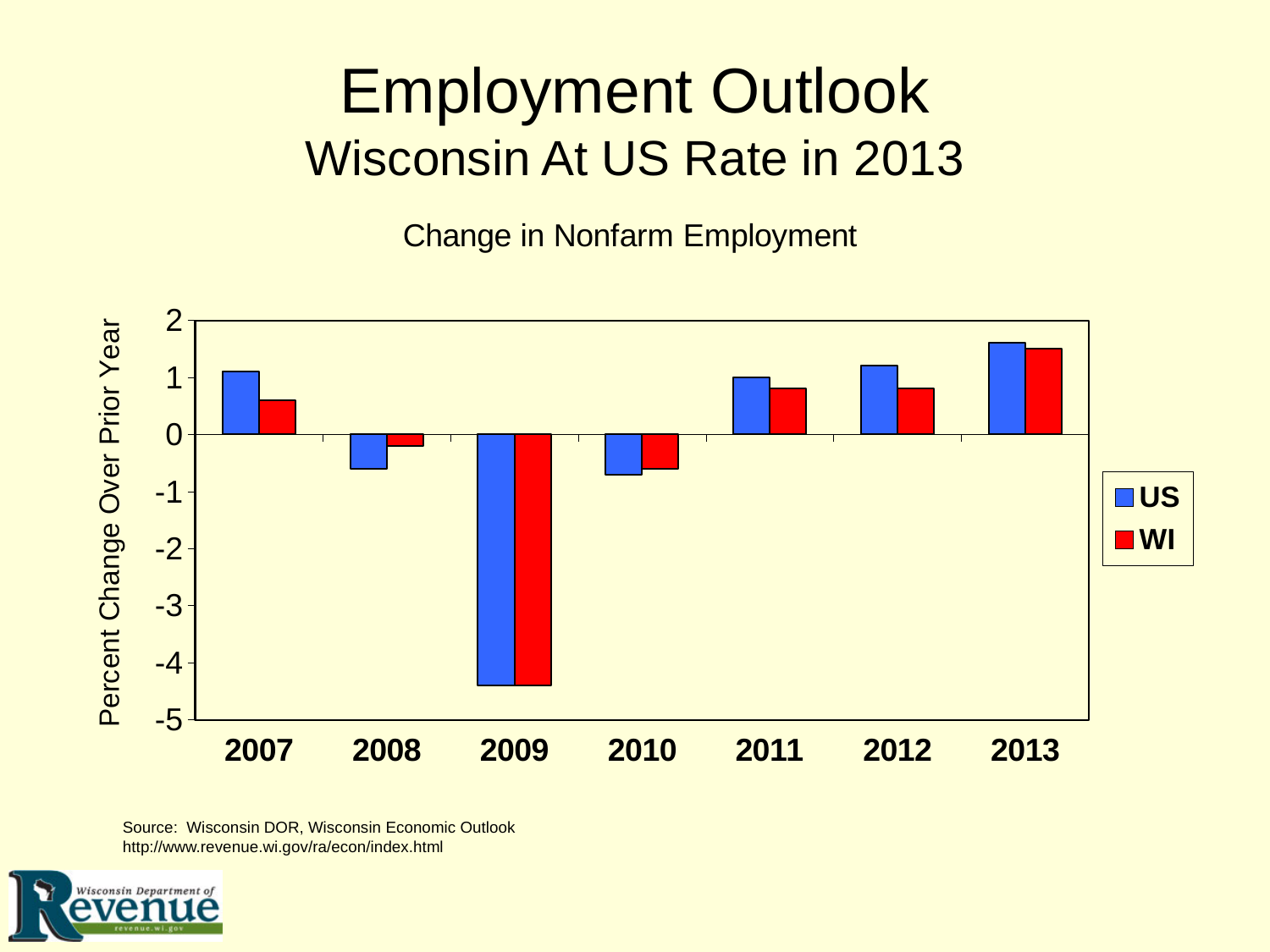
Which year has the lowest value for the US series? 2009 What kind of chart is shown on the slide? bar chart How many series does the legend list? 2 What is the label on the vertical axis? Percent Change Over Prior Year In 2007, which is larger, the US value or the WI value? US Is the value for US in 2009 greater or less than -4? less How many years are shown on the x axis? 7 Is the value for WI in 2008 greater or less than -1? greater In 2008, which is larger, the US value or the WI value? WI Is the value for WI in 2007 greater or less than 1? less Which year has the highest value for the WI series? 2013